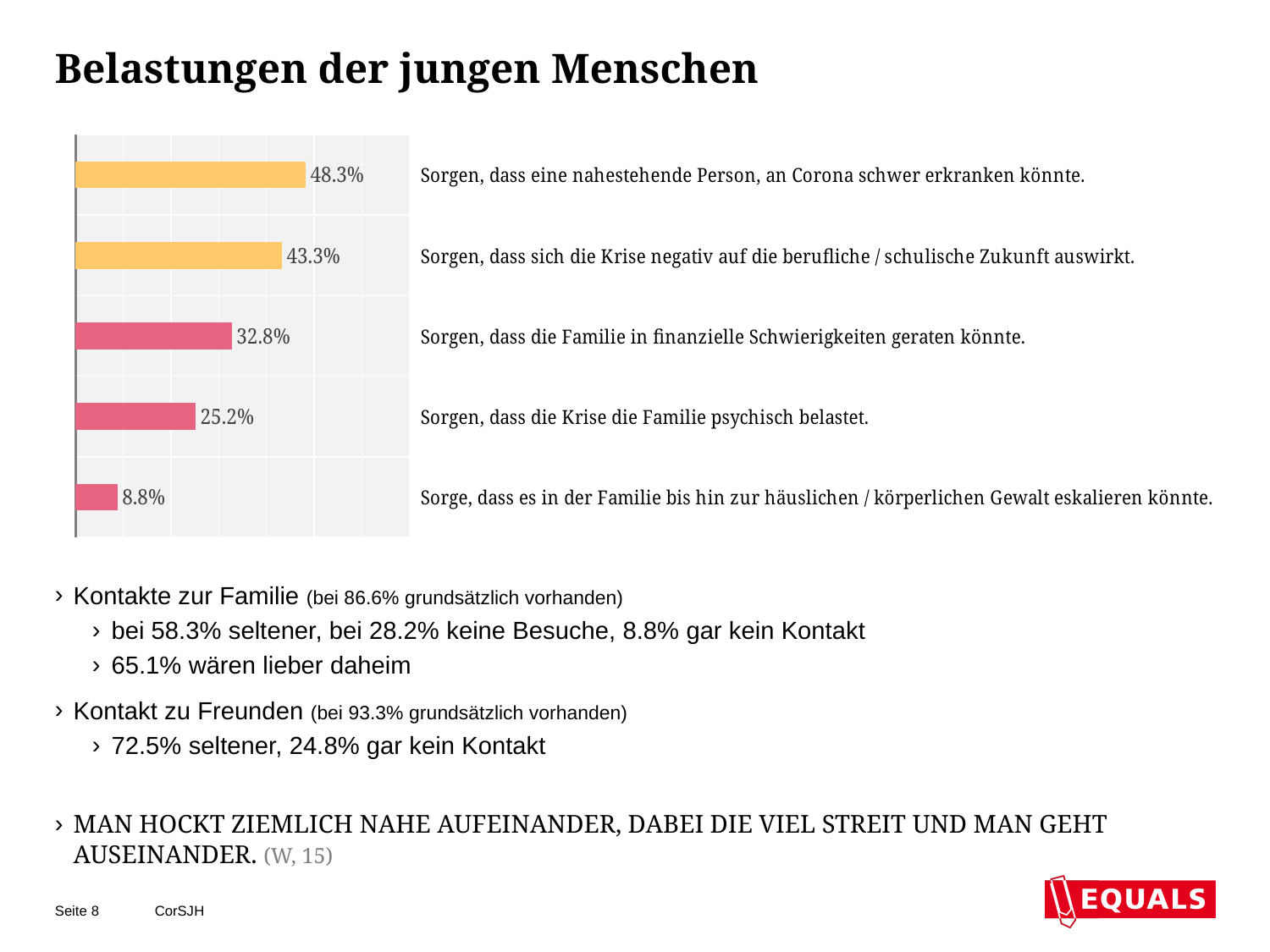
Which is larger: the value for worry about the family being psychologically burdened or the value for worry about escalation to domestic violence? Worry about the family being psychologically burdened (25.2%) What is the value for the worry that the crisis psychologically burdens the family? 25.2% What percentage worry that the family could get into financial difficulties? 32.8% What is the difference between the value for worry about a close person getting seriously ill with Corona and the value for worry about financial difficulties in the family? 15.5% What type of chart is shown on the slide? Bar chart How many bars in the chart are coloured orange/yellow rather than pink/red? 2 What is the value for the worry that the crisis negatively affects professional / school future? 43.3% What percentage of young people worry that a close person could become seriously ill with Corona? 48.3% What percentage worry that it could escalate to domestic / physical violence in the family? 8.8% Which worry has the highest value in the chart? Sorgen, dass eine nahestehende Person, an Corona schwer erkranken könnte. Which worry has the lowest value in the chart? Sorge, dass es in der Familie bis hin zur häuslichen / körperlichen Gewalt eskalieren könnte. How many worries (bars) are shown in the chart? 5